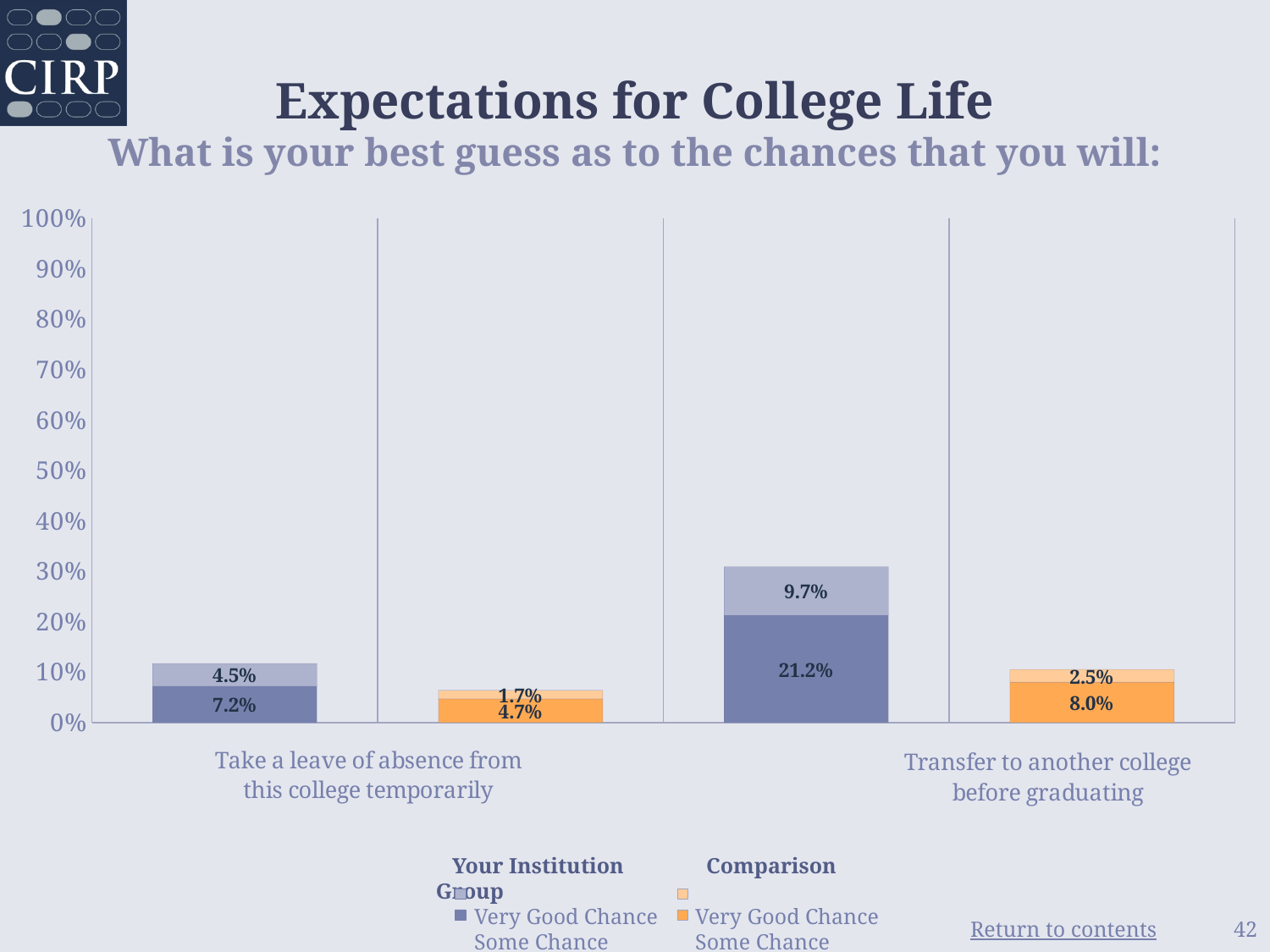
Is the total Your Institution bar for "Transfer to another college before graduating" greater or less than 20%? greater What is the Some Chance value for the Comparison Group for "Take a leave of absence from this college temporarily"? 4.7% How many series does the legend list? 4 What kind of chart is shown on the slide? Stacked bar chart What is the total stacked value of the Comparison Group bar for "Take a leave of absence from this college temporarily"? 6.4% What is the Very Good Chance value for Your Institution for "Take a leave of absence from this college temporarily"? 4.5% What is the Very Good Chance value for the Comparison Group for "Transfer to another college before graduating"? 2.5% Which stacked bar is the tallest on the chart? Your Institution, Transfer to another college before graduating What is the Some Chance value for Your Institution for "Transfer to another college before graduating"? 21.2% What is the difference between the Very Good Chance values for Your Institution and the Comparison Group for "Transfer to another college before graduating"? 7.2% What is the total stacked value of the Your Institution bar for "Transfer to another college before graduating"? 30.9% Which is larger for "Take a leave of absence from this college temporarily": the Very Good Chance value for Your Institution or for the Comparison Group? Your Institution